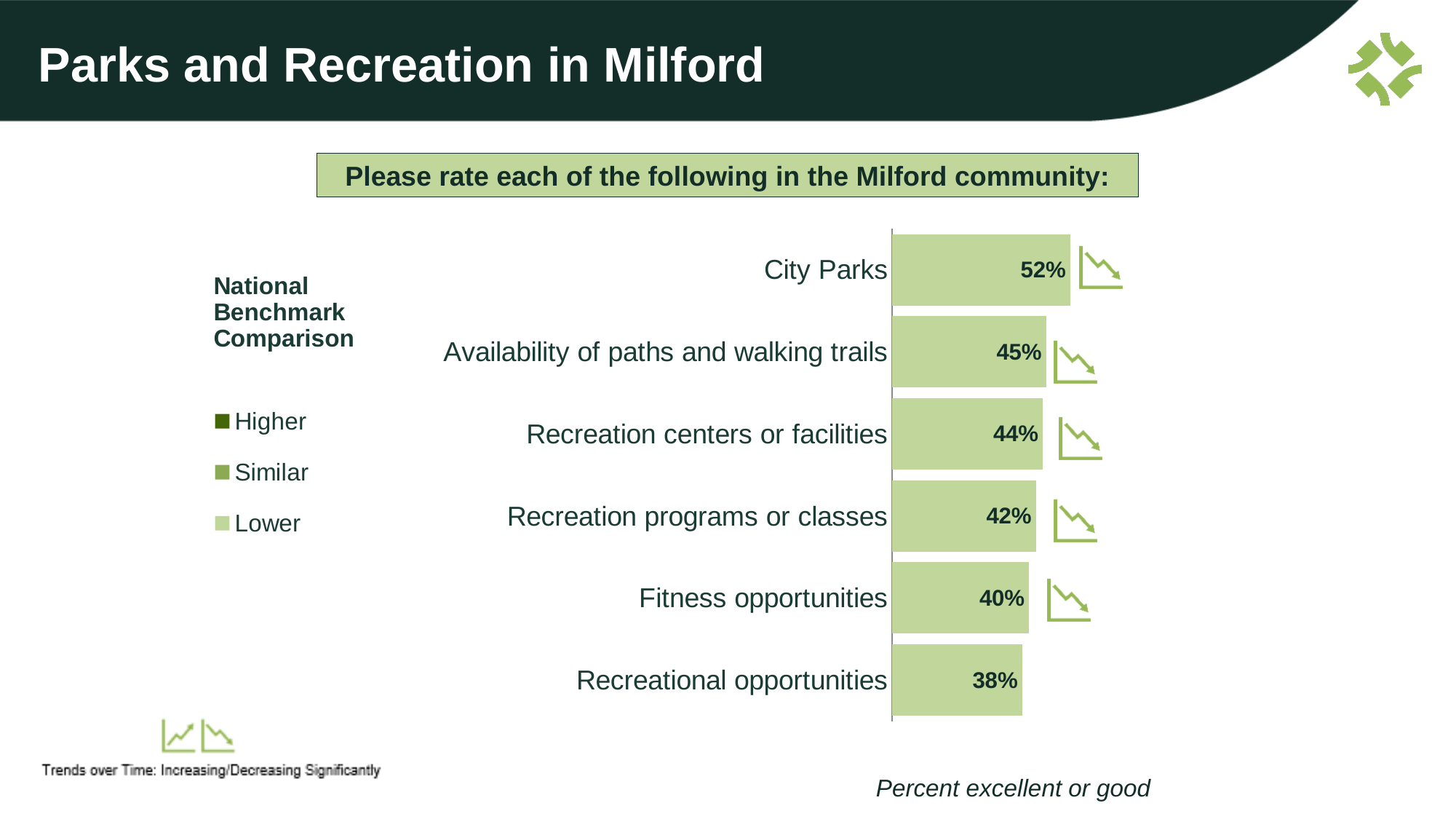
What does the note below the chart say the values represent? Percent excellent or good Which is rated higher, Recreation centers or facilities or Recreation programs or classes? Recreation centers or facilities What percentage rated City Parks as excellent or good? 52% Which category has the highest percentage rating of excellent or good? City Parks What type of chart is shown on the slide? Bar chart What is the value for Recreational opportunities? 38% How many categories are shown in the chart? 6 According to the National Benchmark Comparison legend, what does the light green bar colour indicate? Lower What is the difference in percentage points between City Parks and Fitness opportunities? 12 What is the value for Recreation programs or classes? 42% Which category has the lowest percentage rating of excellent or good? Recreational opportunities What is the value for Availability of paths and walking trails? 45%